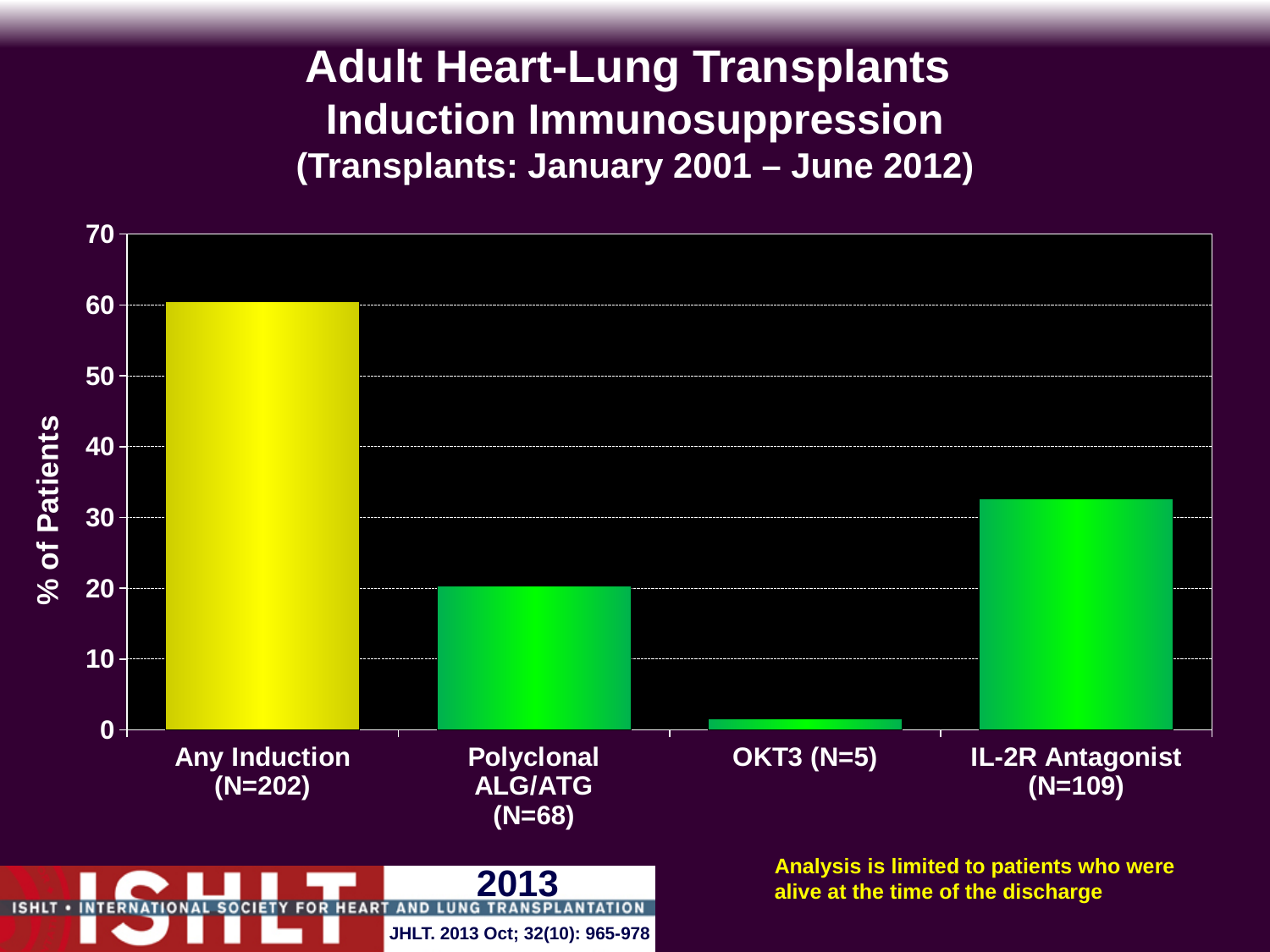
Is the value for IL-2R Antagonist (N=109) greater or less than 40? less What transplant date range is given in the chart title? January 2001 – June 2012 Which is larger, the value for Polyclonal ALG/ATG (N=68) or the value for IL-2R Antagonist (N=109)? IL-2R Antagonist (N=109) Which category has the highest % of Patients? Any Induction (N=202) Is the value for OKT3 (N=5) greater or less than 10? less Is the value for Any Induction (N=202) greater or less than 50? greater What is the label of the y axis? % of Patients What kind of chart is shown on the slide? bar chart Which category has the lowest % of Patients? OKT3 (N=5) How many categories are plotted on the x axis? 4